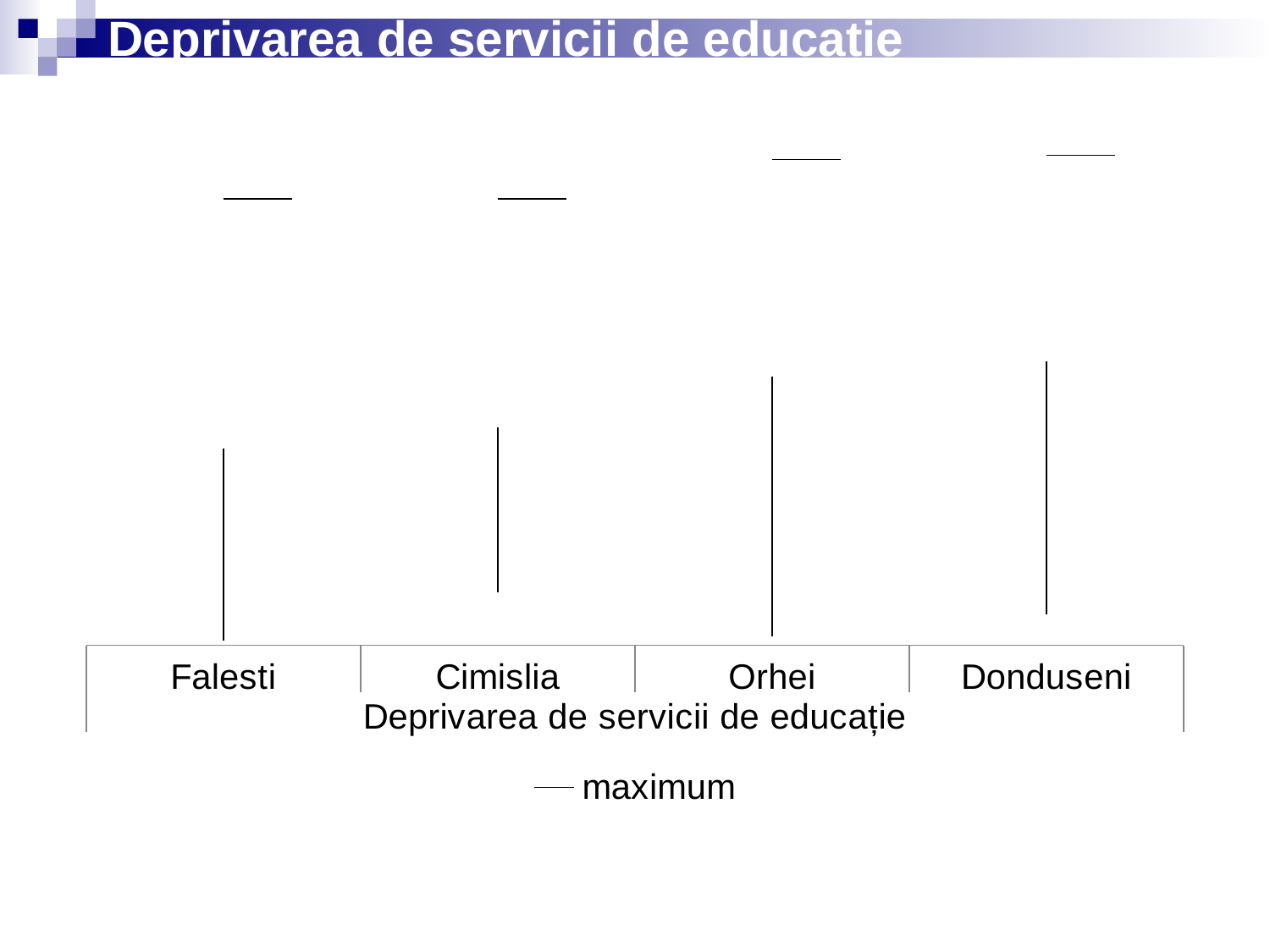
Which category appears between Cimislia and Donduseni on the x axis? Orhei How many categories are shown along the x axis of the chart? 4 Which has the higher 'maximum' marker on the chart, Falesti or Donduseni? Donduseni Which has the higher 'maximum' marker on the chart, Cimislia or Orhei? Orhei Which category is the last (rightmost) on the x axis of the chart? Donduseni What is the axis title shown below the category labels of the chart? Deprivarea de servicii de educație How many series does the chart's legend list? 1 Which category is the first (leftmost) on the x axis of the chart? Falesti What is the name of the series listed in the chart's legend? maximum